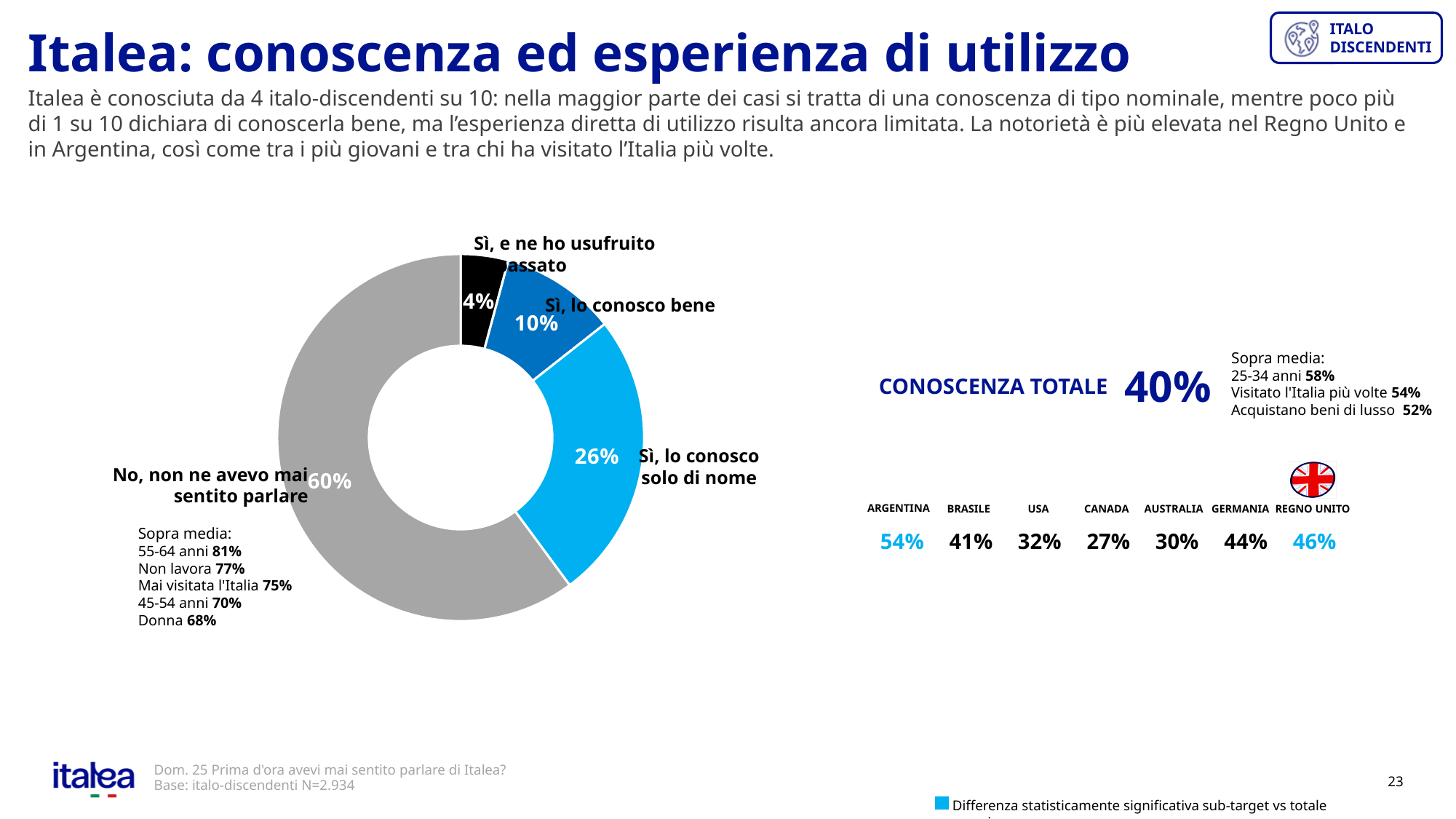
What is the value shown for "CONOSCENZA TOTALE" next to the donut chart? 40% What percentage of respondents answered "Sì, lo conosco solo di nome"? 26% What is the difference in percentage points between "Sì, lo conosco solo di nome" and "Sì, lo conosco bene"? 16 percentage points Which slice of the donut chart is the largest? No, non ne avevo mai sentito parlare What colour is the "No, non ne avevo mai sentito parlare" slice in the donut chart? Grey Which slice of the donut chart is the smallest? Sì, e ne ho usufruito in passato How many slices does the donut chart have? 4 What percentage of respondents answered "Sì, lo conosco bene"? 10% Which is larger: the share for "Sì, lo conosco bene" or for "Sì, e ne ho usufruito in passato"? Sì, lo conosco bene What percentage of respondents answered "Sì, e ne ho usufruito in passato"? 4% What kind of chart is shown on the slide? Pie chart (donut) What percentage of respondents answered "No, non ne avevo mai sentito parlare"? 60%